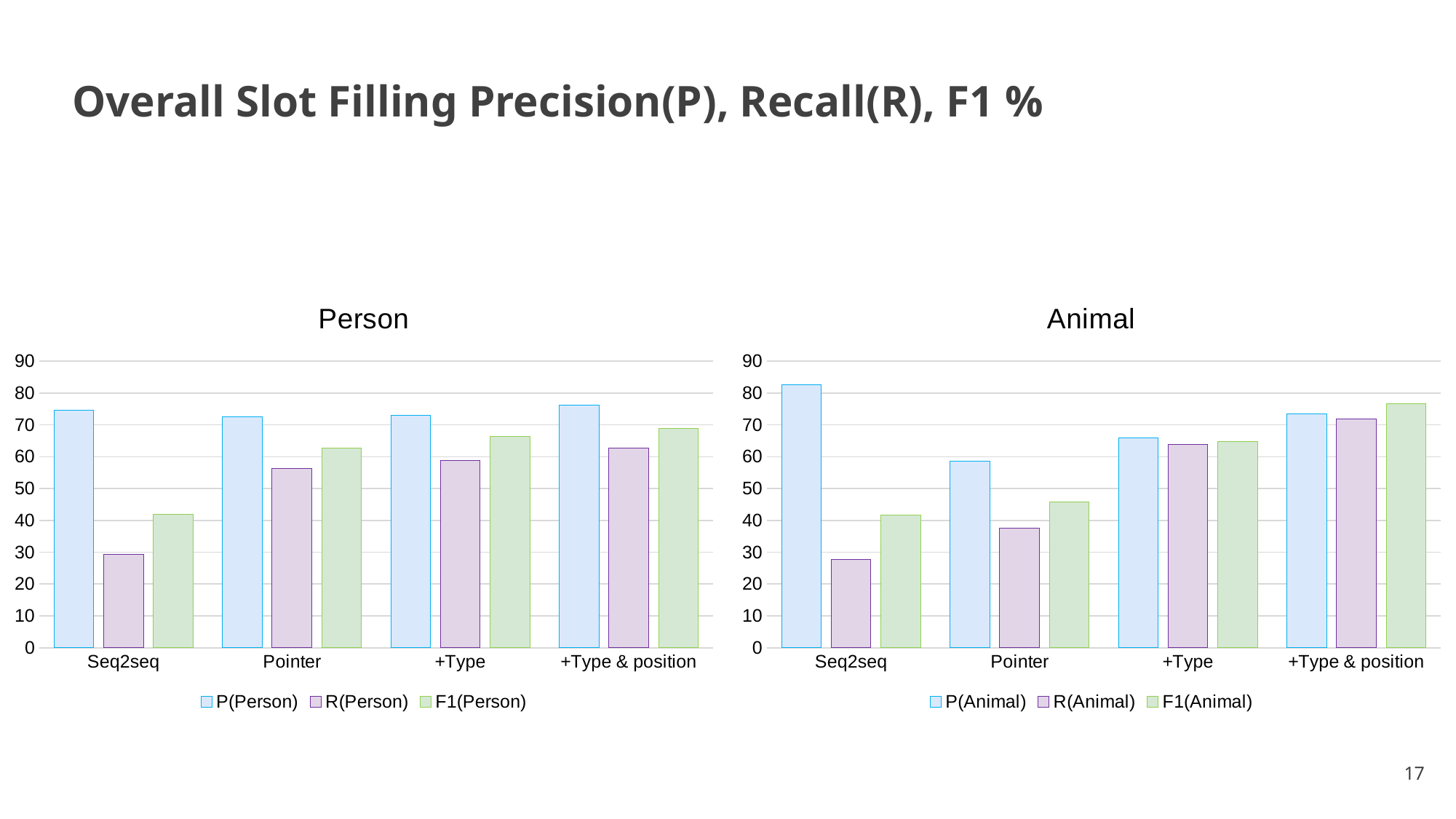
In the Person chart, is the value of R(Person) for Seq2seq greater or less than 40? less In the Animal chart, do the R(Animal) values rise or fall from Seq2seq to +Type & position? rise In the Person chart, which category has the lowest R(Person) value? Seq2seq In the Animal chart, which category has the lowest R(Animal) value? Seq2seq What kind of chart is the Person chart? bar chart In the Animal chart, is the value of F1(Animal) for +Type & position greater or less than 70? greater In the Person chart, do the F1(Person) values rise or fall from Seq2seq to +Type & position? rise In the Animal chart, which is larger for Seq2seq: P(Animal) or R(Animal)? P(Animal) In the Person chart, how many categories are shown on the x axis? 4 In the Person chart, how many series does the legend list? 3 What are the legend entries of the Animal chart? P(Animal), R(Animal), F1(Animal) In the Animal chart, which category has the highest P(Animal) value? Seq2seq